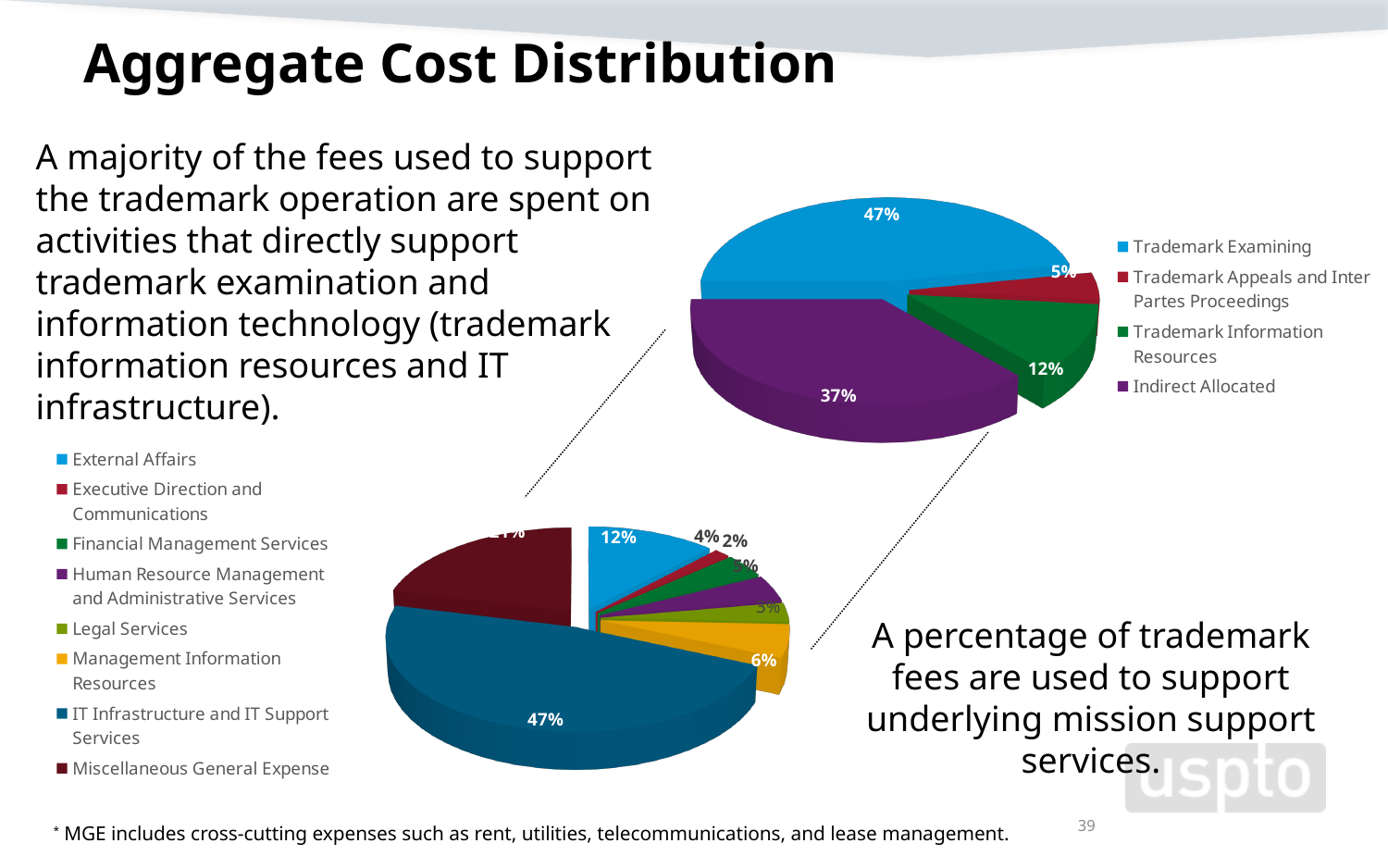
In the top-right pie chart, what percentage is Trademark Appeals and Inter Partes Proceedings? 5% In the bottom pie chart, what percentage is IT Infrastructure and IT Support Services? 47% In the top-right pie chart, what percentage is Indirect Allocated? 37% In the bottom pie chart, what percentage is External Affairs? 12% In the bottom pie chart, which is larger, Executive Direction and Communications or Financial Management Services? Financial Management Services In the top-right pie chart, what percentage is Trademark Examining? 47% In the top-right pie chart, what is the difference in percentage points between Trademark Examining and Indirect Allocated? 10 In the top-right pie chart, which category has the smallest share? Trademark Appeals and Inter Partes Proceedings In the top-right pie chart, which category has the largest share? Trademark Examining How many categories does the legend of the top-right pie chart list? 4 In the top-right pie chart, what percentage is Trademark Information Resources? 12% What type of chart is used on this slide? Pie chart